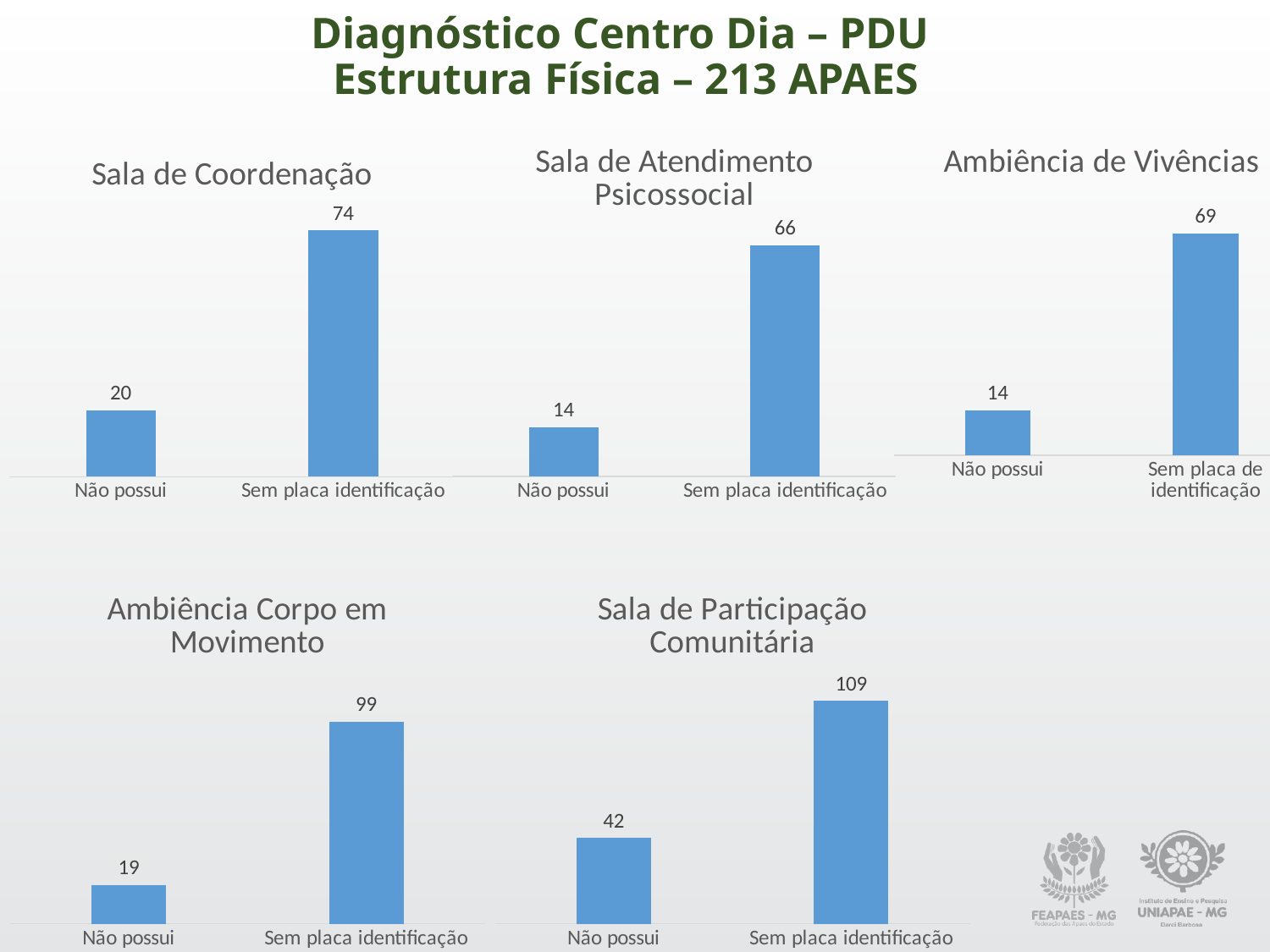
In the 'Sala de Participação Comunitária' chart, what is the value for 'Não possui'? 42 In the 'Ambiência Corpo em Movimento' chart, which category has the lowest value? Não possui In the 'Sala de Coordenação' chart, what is the value for 'Sem placa identificação'? 74 In the 'Sala de Participação Comunitária' chart, which category has the highest value? Sem placa identificação What type of chart is the 'Sala de Atendimento Psicossocial' chart? Bar chart In the 'Sala de Atendimento Psicossocial' chart, what is the value for 'Sem placa identificação'? 66 How many categories does the 'Ambiência de Vivências' chart show? 2 In the 'Sala de Coordenação' chart, what is the value for 'Não possui'? 20 In the 'Sala de Participação Comunitária' chart, what is the difference between 'Sem placa identificação' and 'Não possui'? 67 In the 'Ambiência Corpo em Movimento' chart, what is the value for 'Sem placa identificação'? 99 In the 'Sala de Coordenação' chart, what is the difference between 'Sem placa identificação' and 'Não possui'? 54 In the 'Ambiência de Vivências' chart, what is the value for 'Não possui'? 14